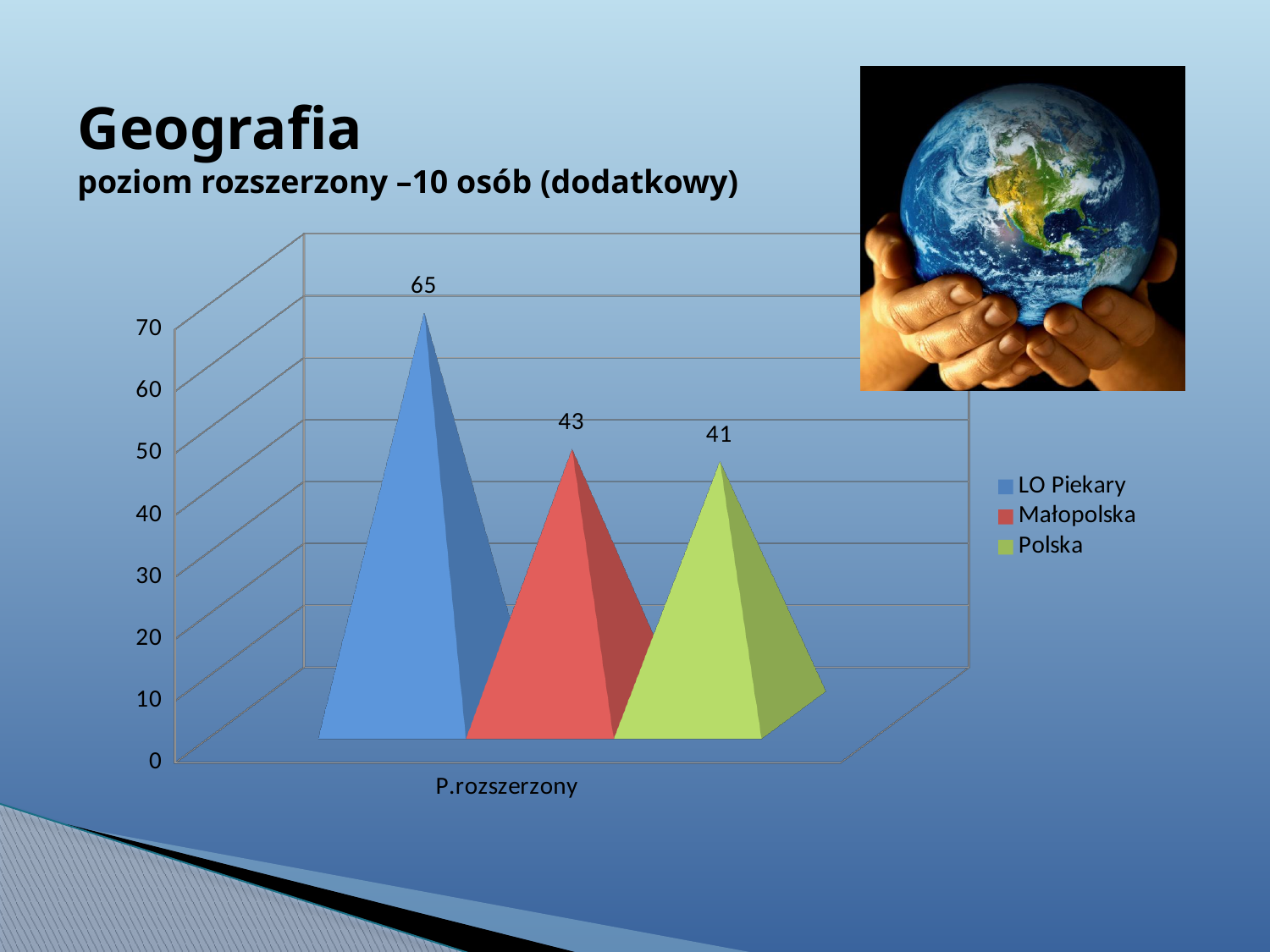
Which is larger, the value for LO Piekary or the value for Małopolska? LO Piekary What is the value for Małopolska in the P.rozszerzony category? 43 How many series does the legend list? 3 What is the difference between the Małopolska value and the Polska value? 2 What is the label of the category on the x axis? P.rozszerzony What is the difference between the LO Piekary value and the Polska value? 24 What is the value for Polska in the P.rozszerzony category? 41 What is the value for LO Piekary in the P.rozszerzony category? 65 Which series has the lowest value? Polska Is the value for LO Piekary greater or less than 60? greater What kind of chart is shown on the slide? bar chart Which series has the highest value? LO Piekary